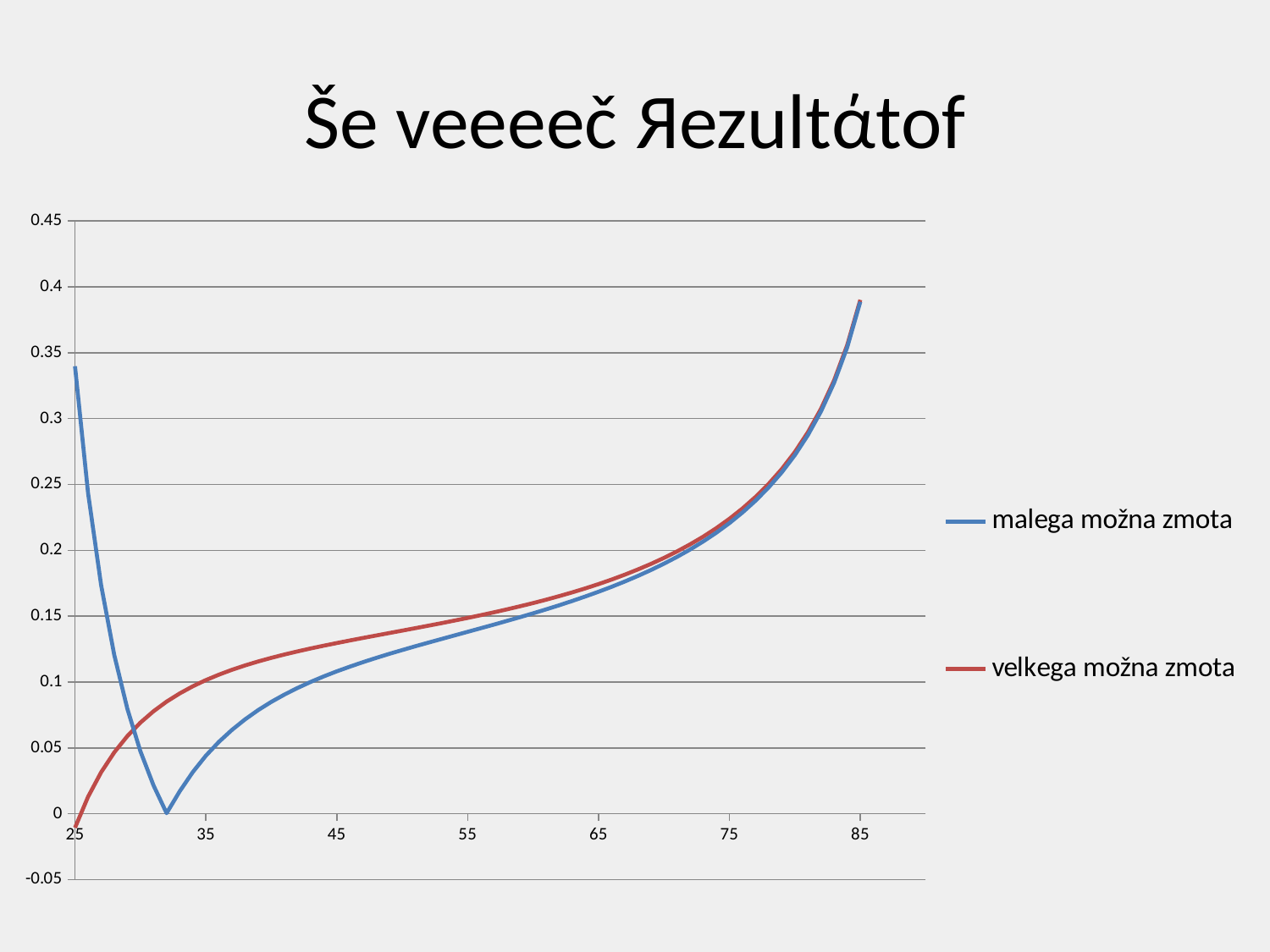
What kind of chart is shown on the slide? line chart At x = 45, which series has the higher value, malega možna zmota or velkega možna zmota? velkega možna zmota Is the value of velkega možna zmota at x = 85 greater or less than 0.35? greater Does the velkega možna zmota line rise or fall as x increases from 25 to 85? rises How many series does the legend list? 2 Is the value of velkega možna zmota at x = 25 greater or less than 0.05? less Which colour is the line for velkega možna zmota? red What are the two series named in the legend? malega možna zmota and velkega možna zmota At x = 25, which series has the higher value, malega možna zmota or velkega možna zmota? malega možna zmota Is the value of malega možna zmota at x = 25 greater or less than 0.3? greater